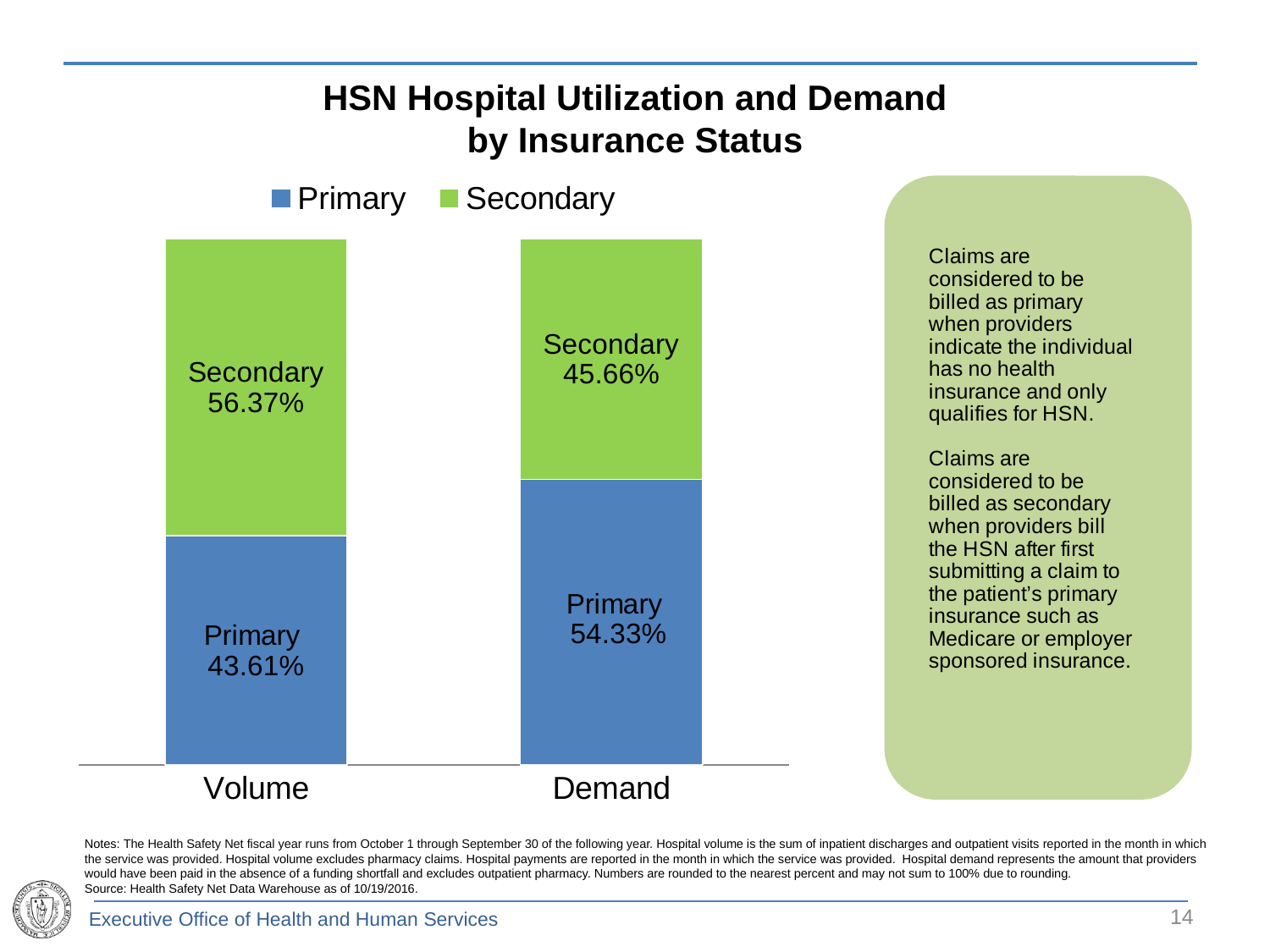
How many series does the legend list? 2 Which category has the higher Secondary share, Volume or Demand? Volume What is the difference between the Primary shares for Demand and Volume? 10.72% How many categories are shown on the x axis? 2 What is the Primary share for Demand? 54.33% What kind of chart is shown? Stacked bar chart What is the Secondary share for Demand? 45.66% What is the Secondary share for Volume? 56.37% Which category has the higher Primary share, Volume or Demand? Demand What is the title of the chart? HSN Hospital Utilization and Demand by Insurance Status What is the Primary share for Volume? 43.61% What is the difference between the Secondary and Primary shares for Volume? 12.76%